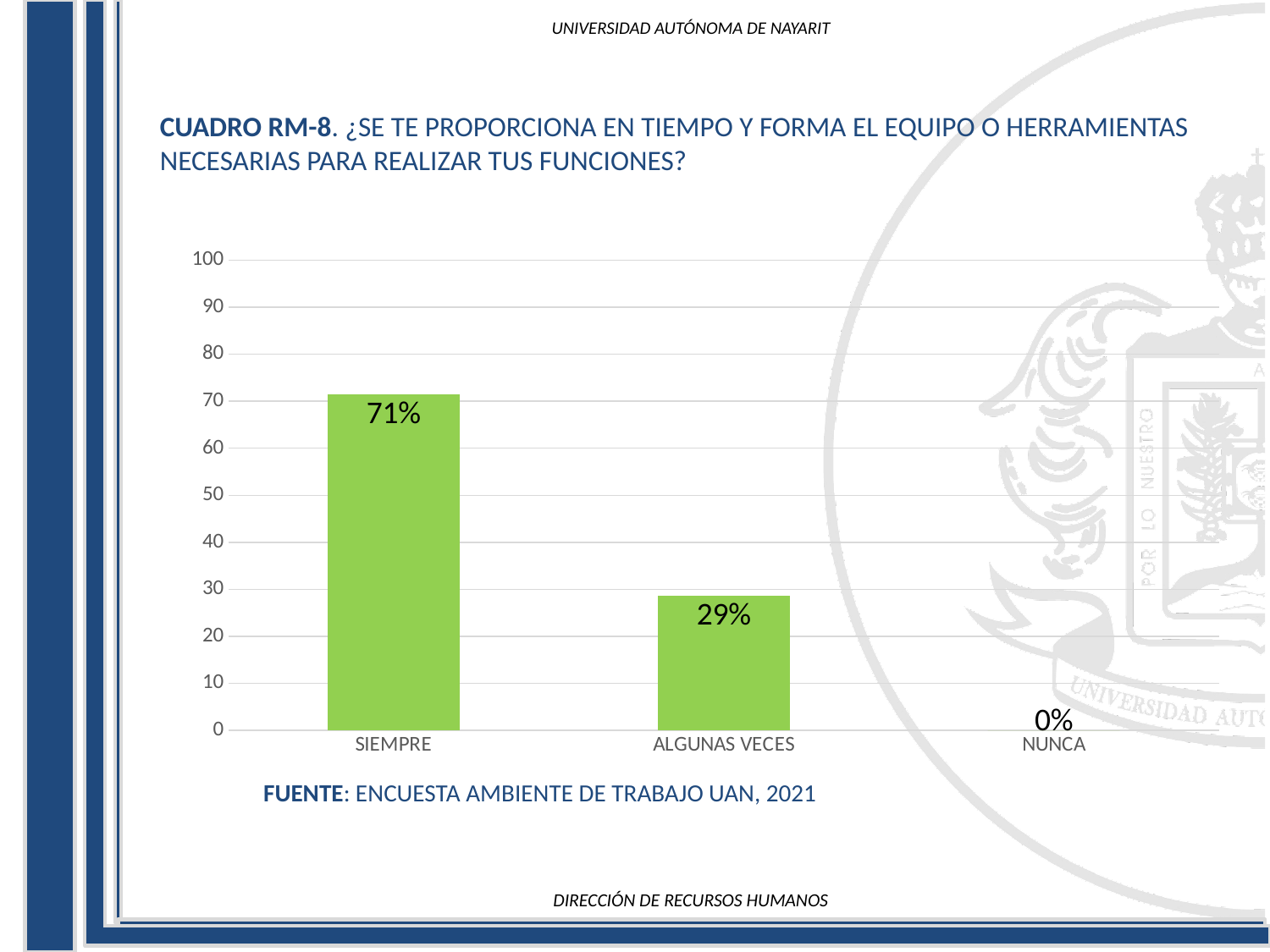
Which is larger, the value for SIEMPRE or the value for ALGUNAS VECES? SIEMPRE How many categories are shown on the x axis? 3 What is the difference between the values for SIEMPRE and ALGUNAS VECES? 42% What is the value for SIEMPRE? 71% Is the value for ALGUNAS VECES greater or less than 40? less What kind of chart is shown on the slide? bar chart Which category has the lowest value? NUNCA Which category has the highest value? SIEMPRE What is the value for ALGUNAS VECES? 29% What is the value for NUNCA? 0% Do the values rise or fall from left to right along the x axis? fall Is the value for SIEMPRE greater or less than 60? greater